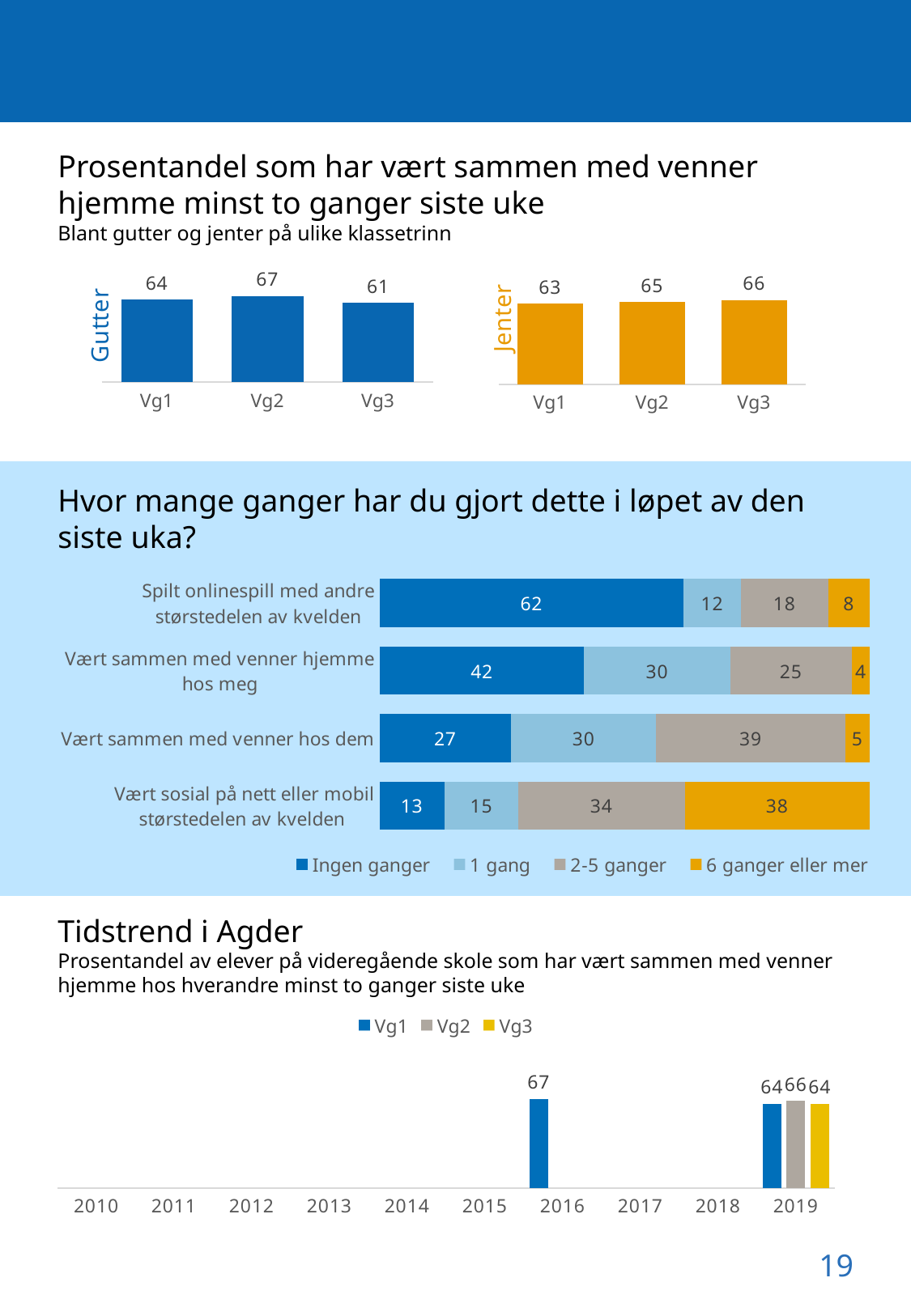
In the 'Tidstrend i Agder' chart, what is the Vg1 value for 2016? 67 In the chart 'Hvor mange ganger har du gjort dette i løpet av den siste uka?', what is the 'Ingen ganger' value for 'Vært sammen med venner hos dem'? 27 Comparing the top charts, which is larger: the Gutter value for Vg1 or the Jenter value for Vg1? Gutter Vg1 In the chart 'Hvor mange ganger har du gjort dette i løpet av den siste uka?', what is the '6 ganger eller mer' value for 'Vært sosial på nett eller mobil størstedelen av kvelden'? 38 In the Jenter chart at the top, what is the value for Vg3? 66 In the Gutter chart at the top, which class level has the lowest value? Vg3 In the Gutter chart at the top, what is the value for Vg2? 67 In the chart 'Hvor mange ganger har du gjort dette i løpet av den siste uka?', how many series does the legend list? 4 In the chart 'Hvor mange ganger har du gjort dette i løpet av den siste uka?', what is the difference between the 'Ingen ganger' values for 'Spilt onlinespill med andre størstedelen av kvelden' and 'Vært sammen med venner hjemme hos meg'? 20 In the Jenter chart at the top, do the values rise or fall from Vg1 to Vg3? rise In the 'Tidstrend i Agder' chart, what is the Vg2 value for 2019? 66 In the chart 'Hvor mange ganger har du gjort dette i løpet av den siste uka?', how many activities (categories) are shown? 4